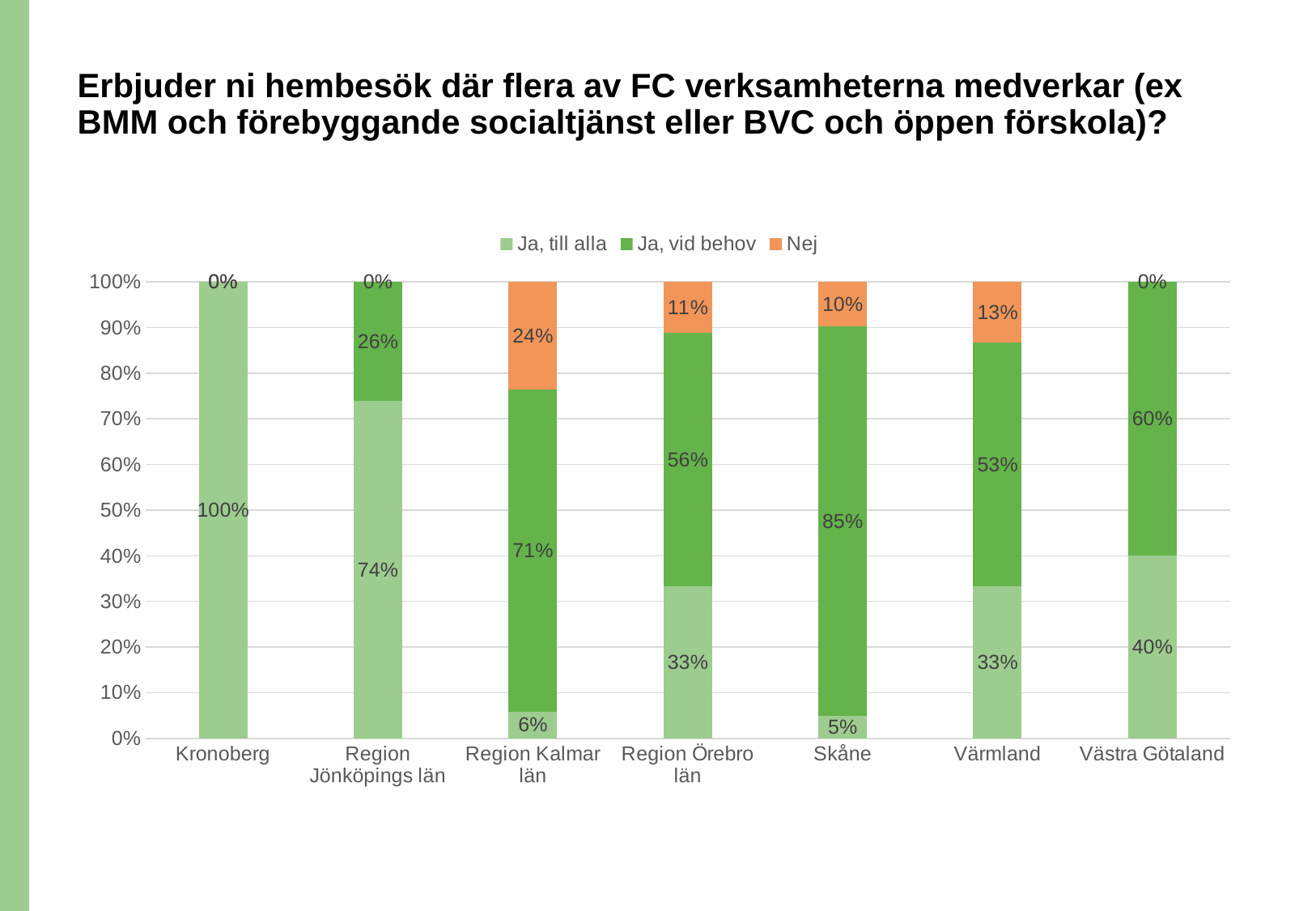
How many regions are shown on the x axis? 7 How many series does the legend list? 3 What is the value for "Ja, till alla" for Västra Götaland? 40% What kind of chart is shown on the slide? Stacked bar chart What is the difference between the "Ja, till alla" values for Region Jönköpings län and Region Örebro län? 41% What is the value for "Nej" for Region Kalmar län? 24% Which region has the highest value for "Ja, vid behov"? Skåne What is the value for "Ja, vid behov" for Skåne? 85% Which region has the lowest value for "Ja, till alla"? Skåne Which is larger: the "Ja, vid behov" value for Värmland or for Västra Götaland? Västra Götaland Which region has the highest value for "Nej"? Region Kalmar län What is the value for "Ja, till alla" for Kronoberg? 100%